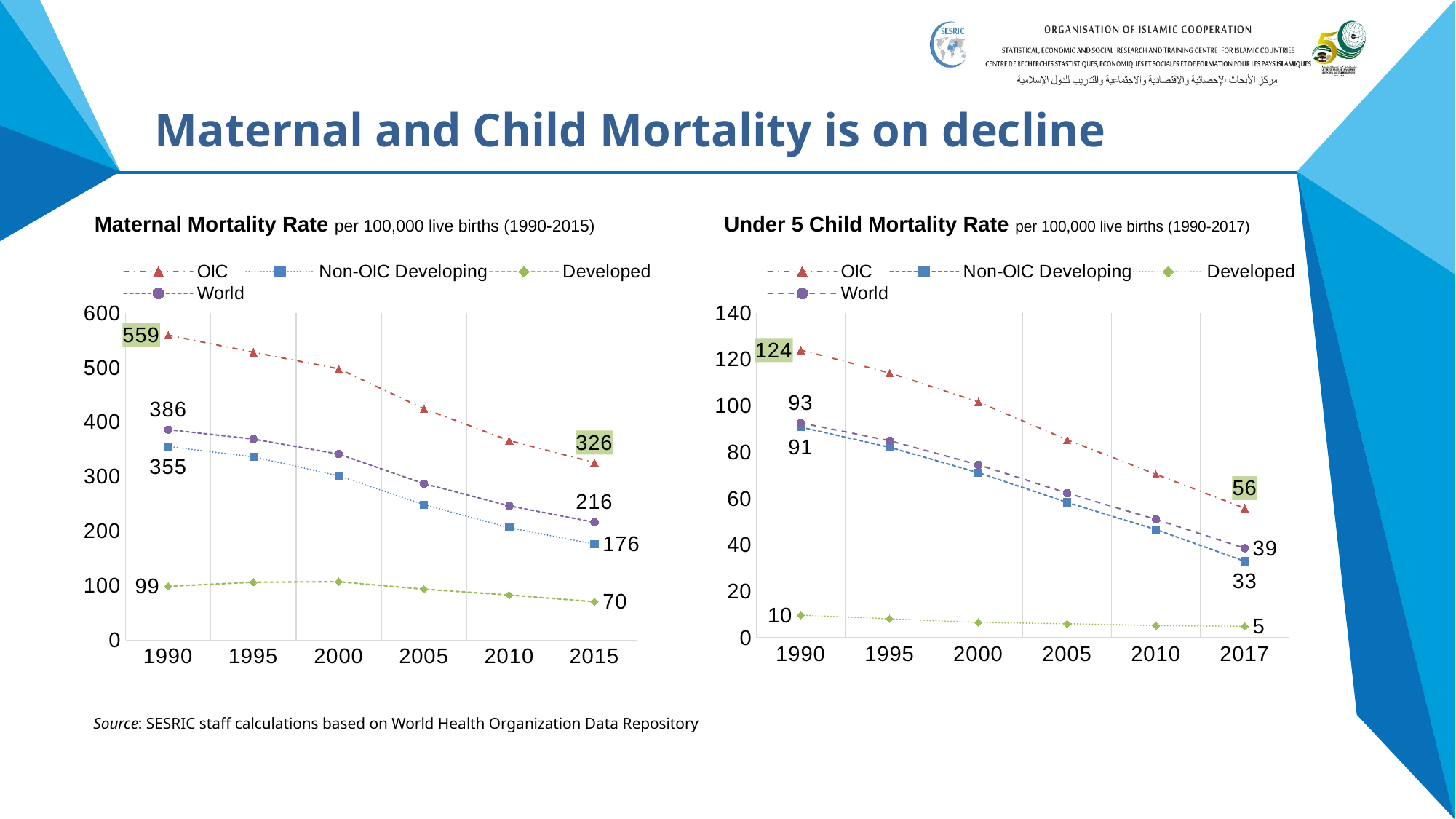
In the Under 5 Child Mortality Rate chart, what is the value for OIC in 2017? 56 In the Under 5 Child Mortality Rate chart, which series has the highest value in 1990? OIC In the Maternal Mortality Rate chart, how many series does the legend list? 4 What kind of chart is the Under 5 Child Mortality Rate chart? line chart In the Under 5 Child Mortality Rate chart, does the OIC series rise or fall from 1990 to 2017? fall In the Maternal Mortality Rate chart, what is the value for Non-OIC Developing in 2015? 176 In the Under 5 Child Mortality Rate chart, what is the value for World in 1990? 93 In the Maternal Mortality Rate chart, by how much did the OIC value fall between 1990 and 2015? 233 In the Maternal Mortality Rate chart, which series has the lowest value in 2015? Developed In the Under 5 Child Mortality Rate chart, what is the difference between the World and Non-OIC Developing values in 2017? 6 In the Maternal Mortality Rate chart, is the OIC value in 2005 greater or less than 400? greater In the Maternal Mortality Rate chart, what is the value for OIC in 1990? 559